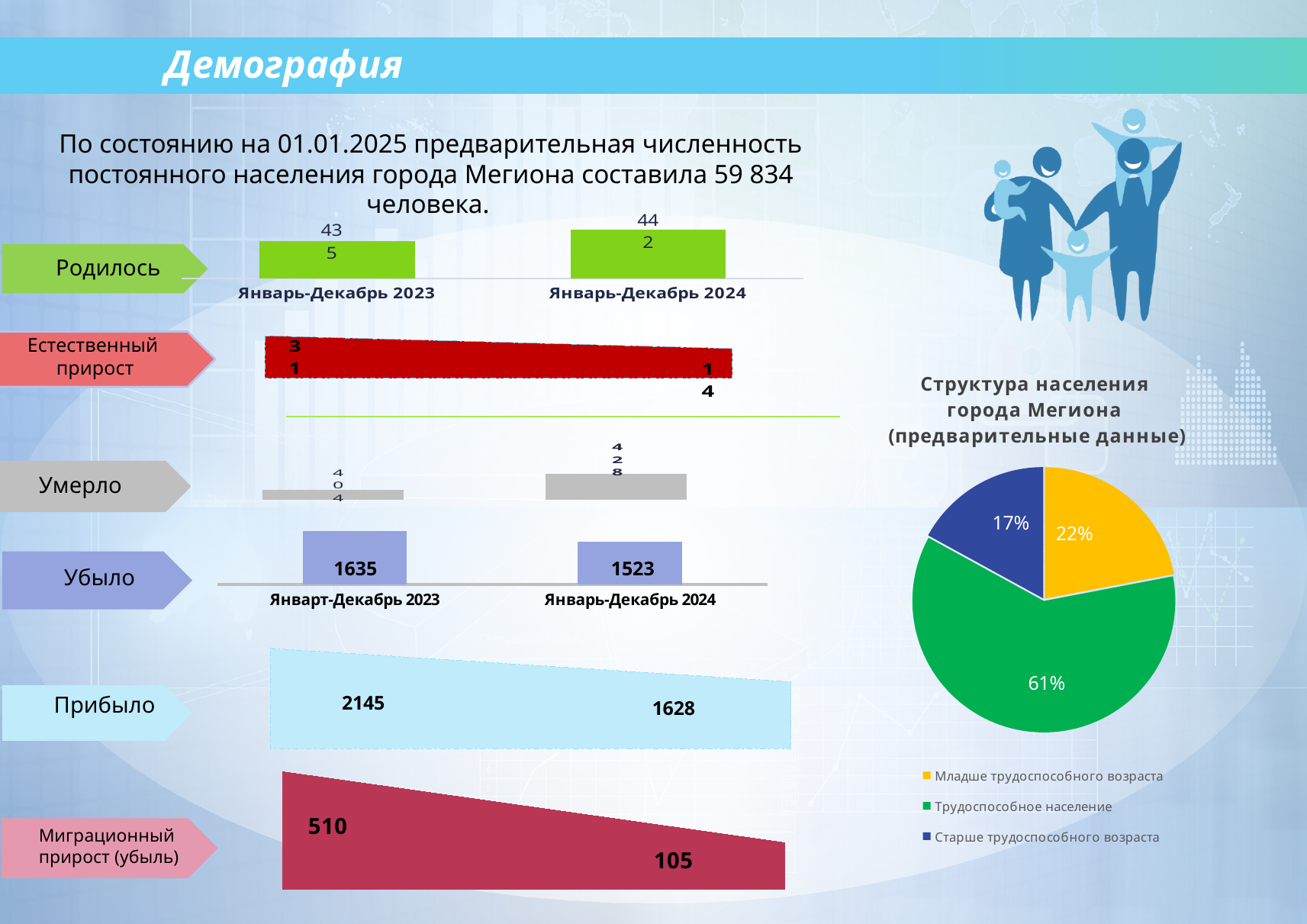
In the pie chart "Структура населения города Мегиона", what colour is the slice for Младше трудоспособного возраста? yellow In the "Убыло" chart, what kind of chart is used? bar chart In the "Миграционный прирост (убыль)" chart, what is the second value shown? 105 In the pie chart "Структура населения города Мегиона", what share is Трудоспособное население? 61% In the pie chart "Структура населения города Мегиона", how many categories does the legend list? 3 In the "Миграционный прирост (убыль)" chart, which of the two values is larger, 510 or 105? 510 In the "Миграционный прирост (убыль)" chart, what is the difference between the two values shown? 405 In the "Прибыло" chart, what is the first (2023) value shown? 2145 In the "Убыло" chart, what is the difference between the 2023 value and the 2024 value? 112 In the "Убыло" chart, what is the value for Январь-Декабрь 2024? 1523 In the "Прибыло" chart, do the values rise or fall from left to right? fall In the pie chart "Структура населения города Мегиона", which category has the smallest share? Старше трудоспособного возраста